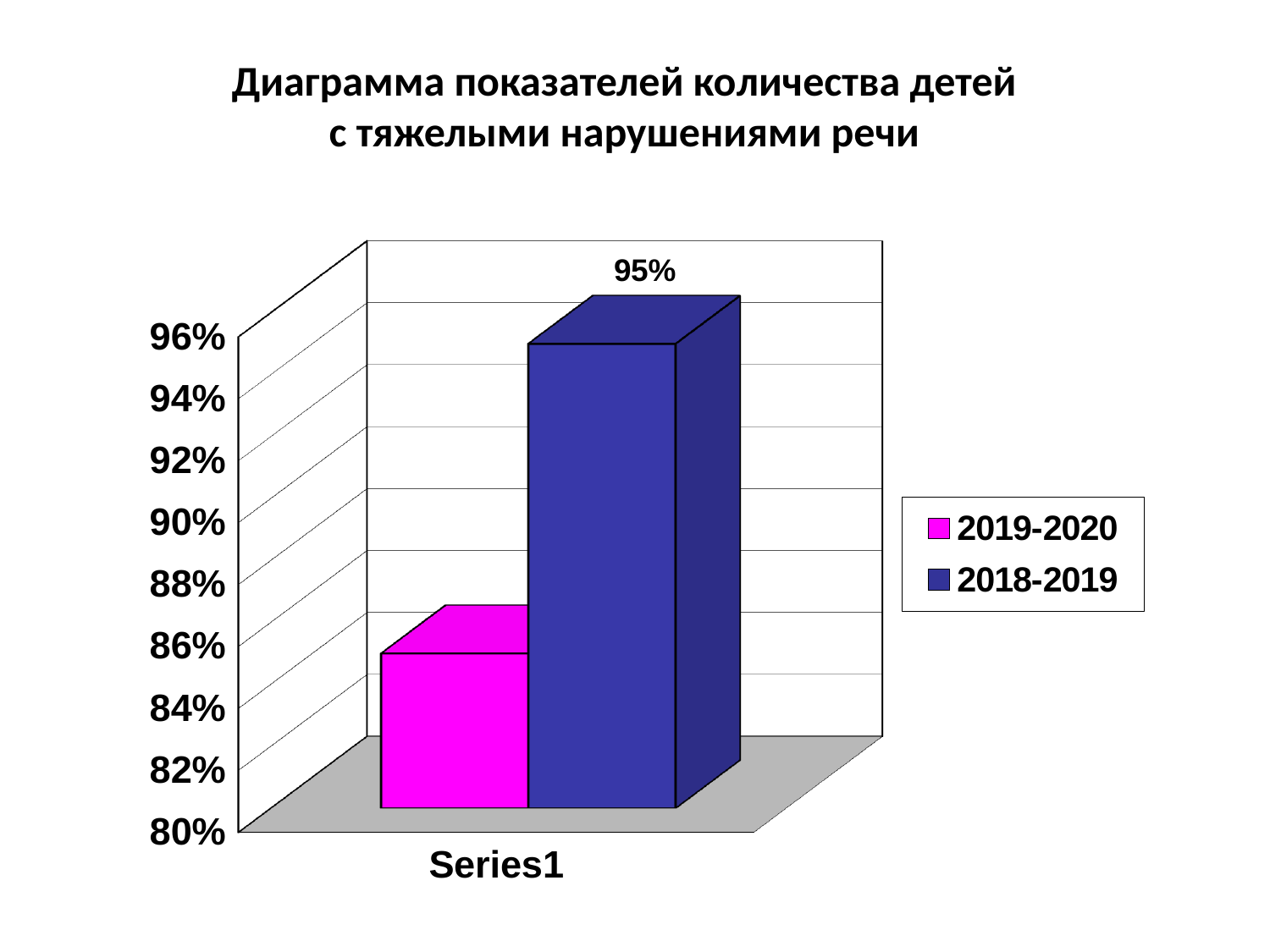
Is the value for 2018-2019 greater or less than 90%? greater Which series has the higher value, 2018-2019 or 2019-2020? 2018-2019 How many series does the legend list? 2 Is the value for 2019-2020 greater or less than 90%? less What is the value shown for the 2018-2019 series? 95% What is the lowest value shown on the vertical axis? 80% What colour is the bar for the 2019-2020 series? magenta How many categories are shown on the x axis? 1 Which series has the lowest value? 2019-2020 What kind of chart is shown on the slide? bar chart Which series has the highest value? 2018-2019